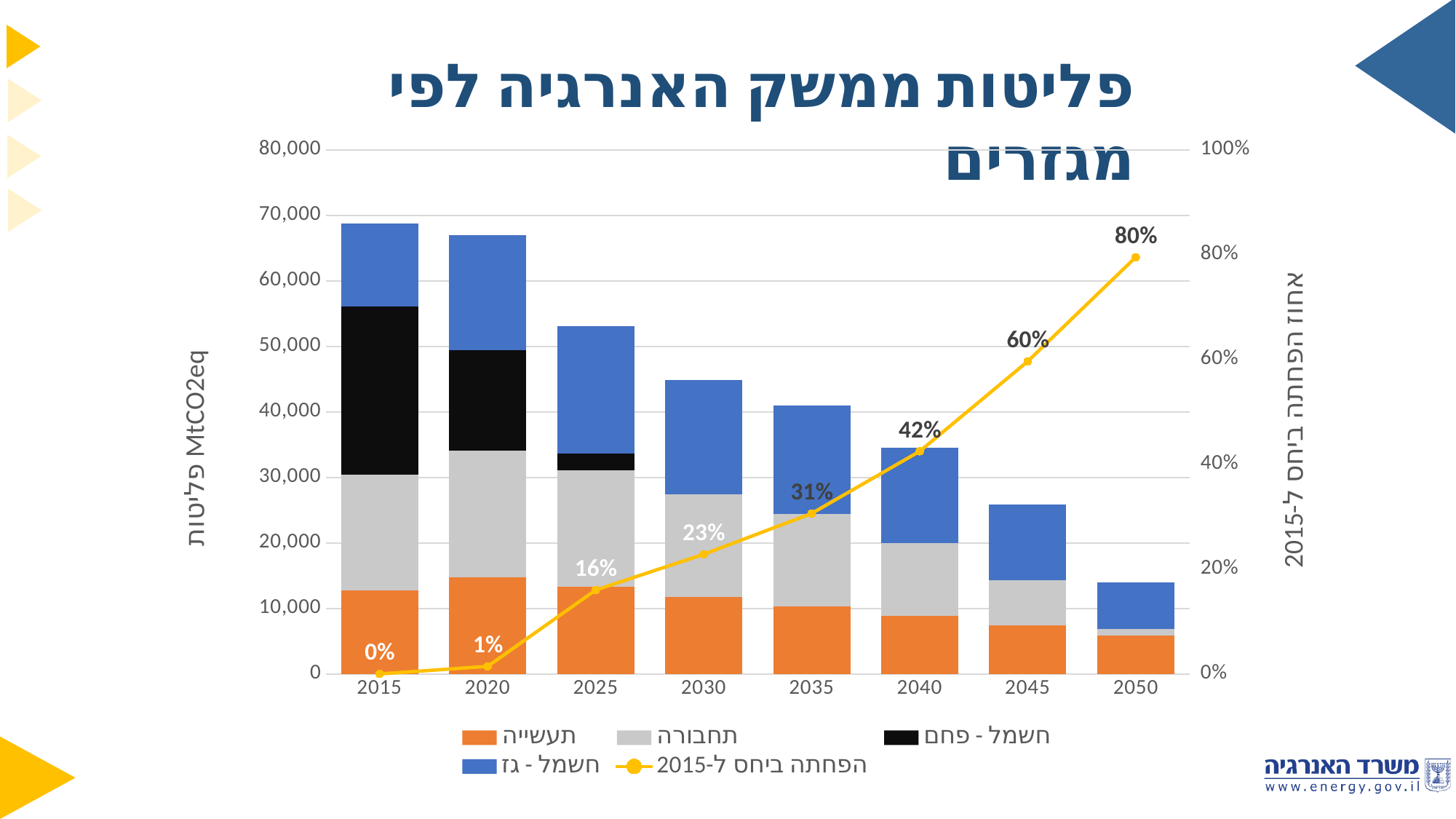
What is the value of the 'הפחתה ביחס ל-2015' line for 2020? 1% What is the difference between the 'הפחתה ביחס ל-2015' values for 2050 and 2045? 20% How many years are shown on the x axis? 8 In which year does the 'הפחתה ביחס ל-2015' line reach its highest value? 2050 Is the total stacked bar value for 2015 greater or less than 60,000? greater What is the value of the 'הפחתה ביחס ל-2015' line for 2050? 80% What is the value of the 'הפחתה ביחס ל-2015' line for 2035? 31% Is the total stacked bar value for 2050 greater or less than 20,000? less Which year has a higher 'הפחתה ביחס ל-2015' value, 2030 or 2040? 2040 In which year is the 'הפחתה ביחס ל-2015' line at its lowest value? 2015 How many series does the legend list? 5 Do the total stacked bar values rise or fall from 2015 to 2050? fall